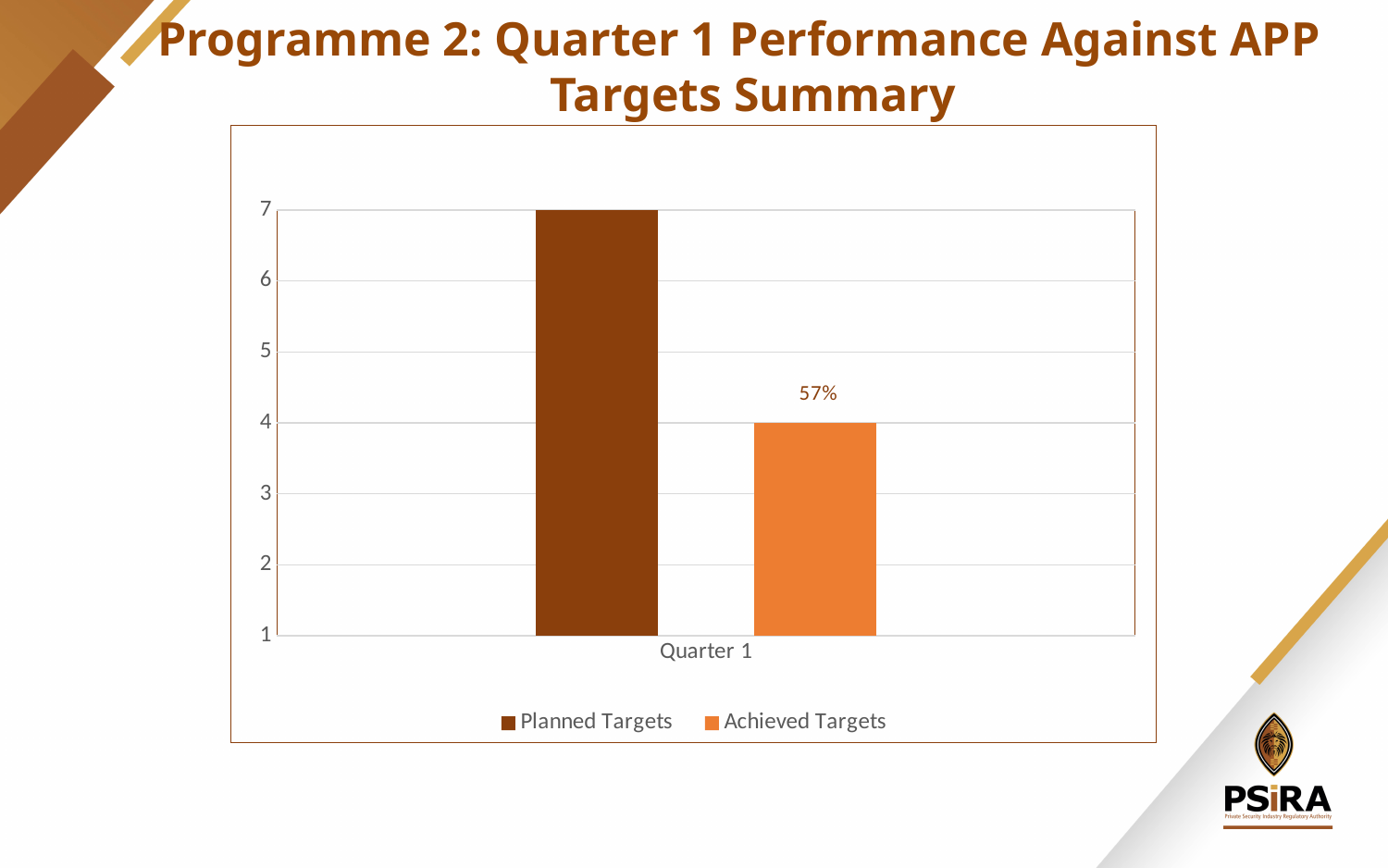
Is the value for Planned Targets greater or less than 6? greater What is the value of the Achieved Targets bar for Quarter 1? 4 How many series does the legend list? 2 What is the value of the Planned Targets bar for Quarter 1? 7 How many categories are shown on the x axis? 1 What type of chart is shown on the slide? bar chart Is the value for Achieved Targets greater or less than 5? less What percentage label is shown above the Achieved Targets bar? 57% Which series has the taller bar for Quarter 1? Planned Targets Is the Achieved Targets value larger or smaller than the Planned Targets value? smaller What is the difference between the Planned Targets and Achieved Targets values for Quarter 1? 3 Which series has the shorter bar for Quarter 1? Achieved Targets